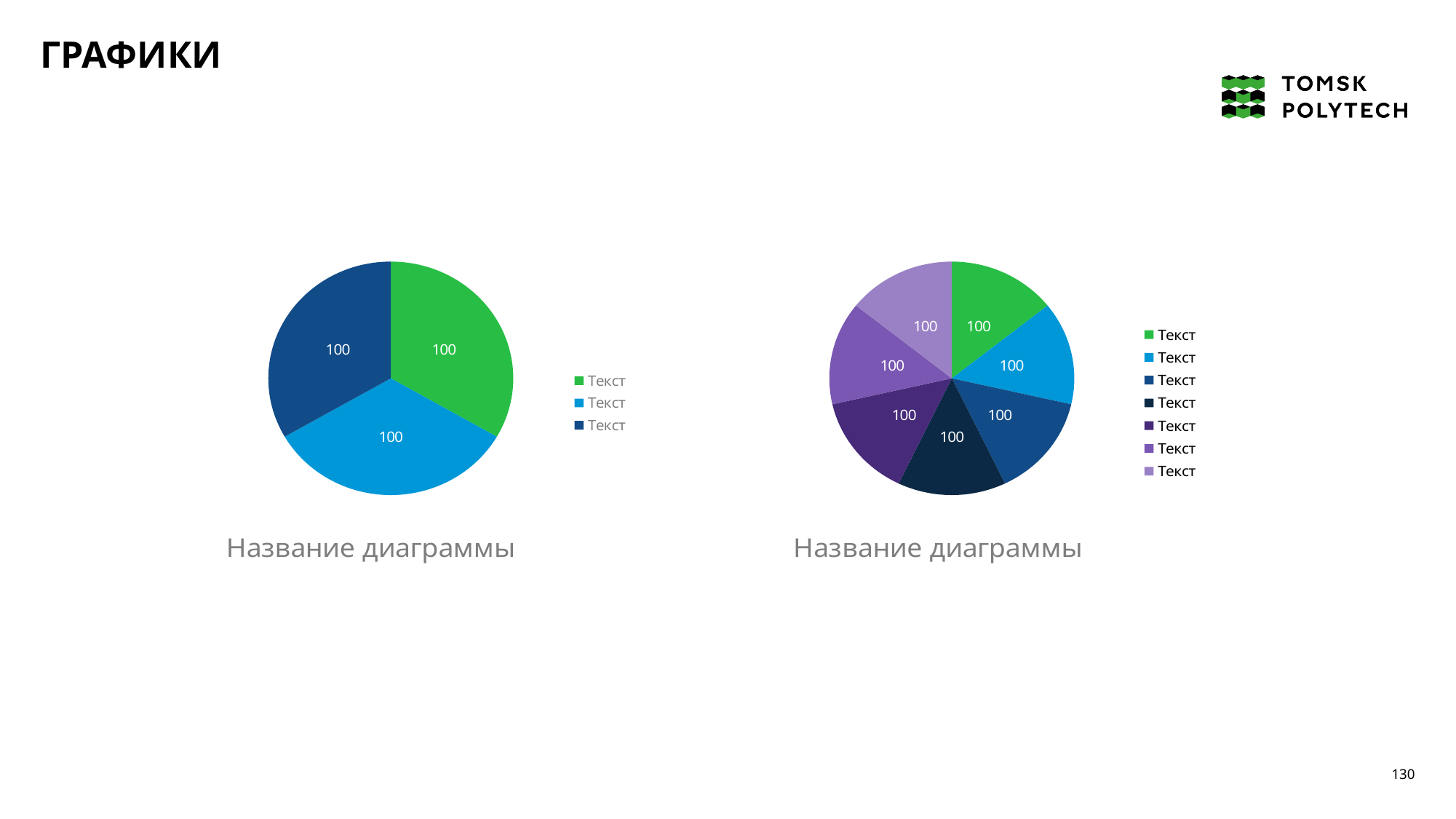
In the left pie chart, is the green slice larger than, smaller than, or equal to the light blue slice? Equal What is the title shown under the left pie chart? Название диаграммы In the left pie chart, what value is shown on the green slice? 100 What kind of chart is the left chart on the slide? Pie chart What is the total of all slice values in the left pie chart? 300 How many entries does the legend of the left pie chart list? 3 What is the total of all slice values in the right pie chart? 700 In the right pie chart, what value is shown on the light purple slice? 100 How many slices does the left pie chart have? 3 What kind of chart is the right chart on the slide? Pie chart How many entries does the legend of the right pie chart list? 7 How many slices does the right pie chart have? 7